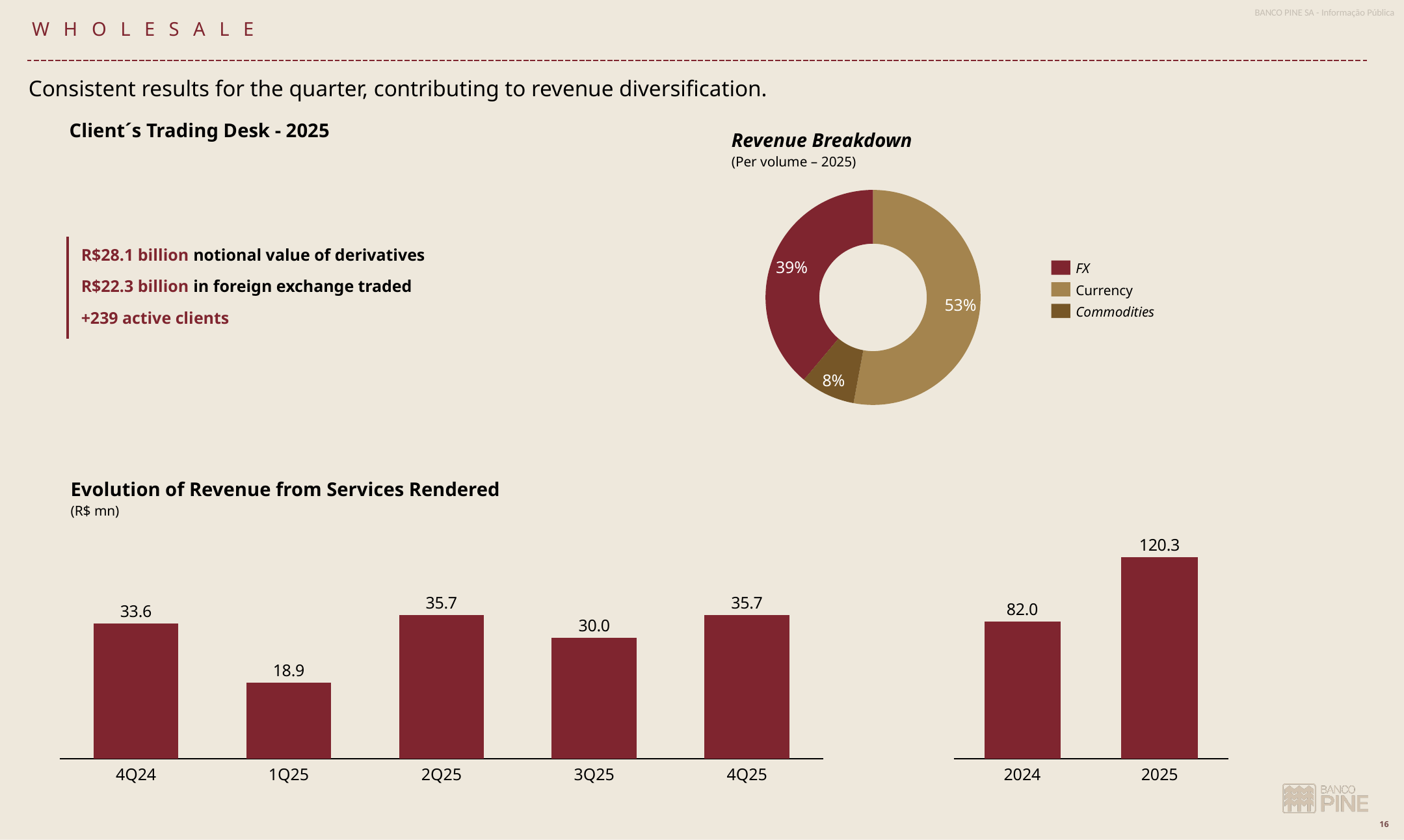
In the Revenue Breakdown chart, how many categories does the legend list? 3 What kind of chart is the Evolution of Revenue from Services Rendered chart? Bar chart In the Revenue Breakdown chart, which category has the largest share? Currency In the Revenue Breakdown chart, what share does Currency have? 53% In the Evolution of Revenue from Services Rendered chart, which quarter has the lowest value? 1Q25 What kind of chart is the Revenue Breakdown chart? Donut (pie) chart In the Evolution of Revenue from Services Rendered chart, what is the value for 1Q25? 18.9 In the Revenue Breakdown chart, which category has the smallest share? Commodities In the Revenue Breakdown chart, what share does FX have? 39% In the Evolution of Revenue from Services Rendered chart, what is the difference between 2025 and 2024? 38.3 In the Evolution of Revenue from Services Rendered chart, which is larger, 4Q24 or 3Q25? 4Q24 In the Evolution of Revenue from Services Rendered chart, what is the value for 2025? 120.3